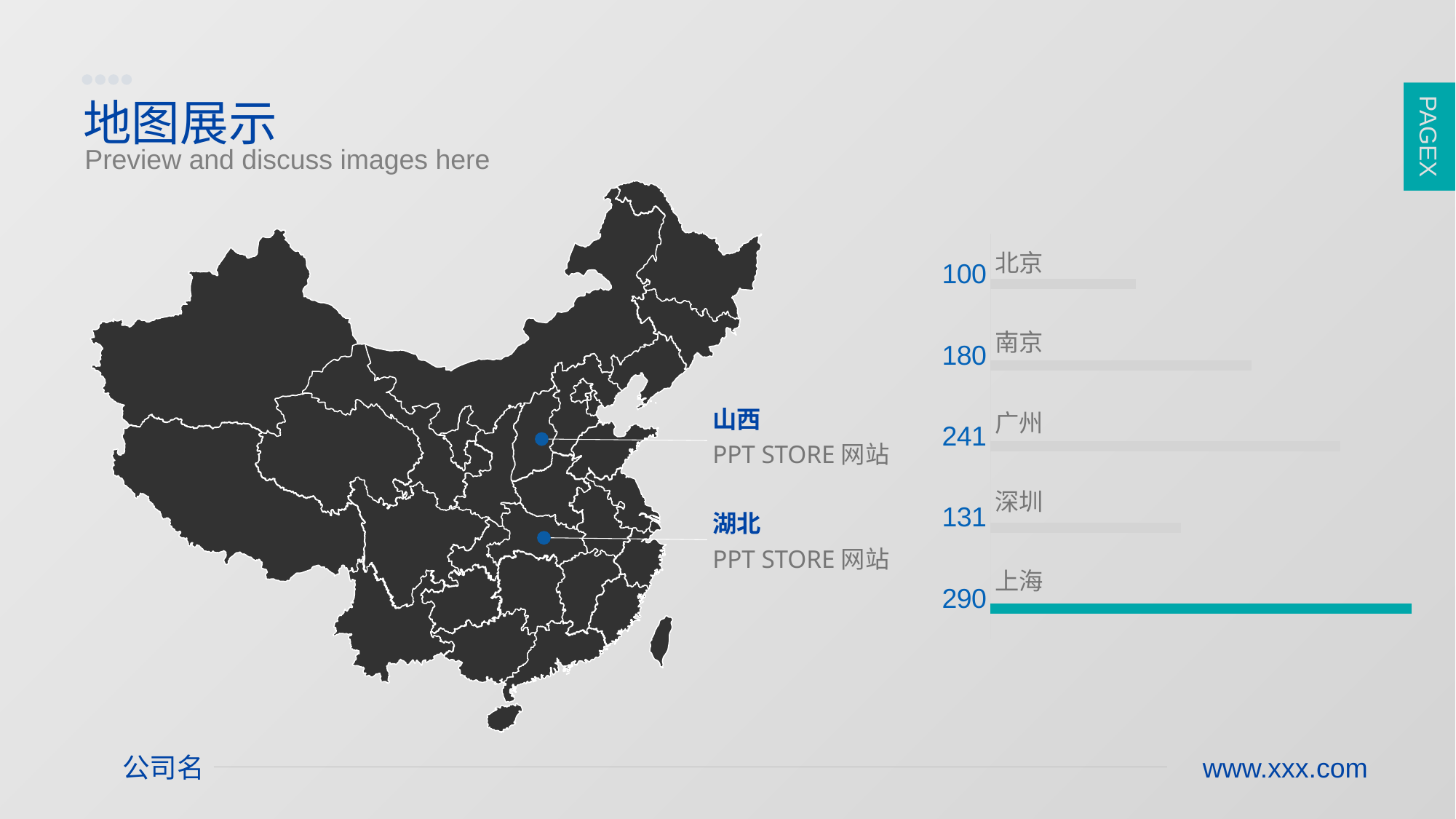
What is the difference between the values for 上海 and 北京? 190 Which bar in the chart is coloured teal rather than grey? 上海 Which city has the lowest value in the bar chart? 北京 What kind of chart is shown on the right side of the slide? bar chart Which city has the highest value in the bar chart? 上海 What is the value for 北京 in the bar chart? 100 How many cities are shown in the bar chart? 5 What is the value for 南京 in the bar chart? 180 What is the difference between the values for 广州 and 南京? 61 What is the value for 广州 in the bar chart? 241 Which has a larger value, 南京 or 深圳? 南京 What is the value for 深圳 in the bar chart? 131